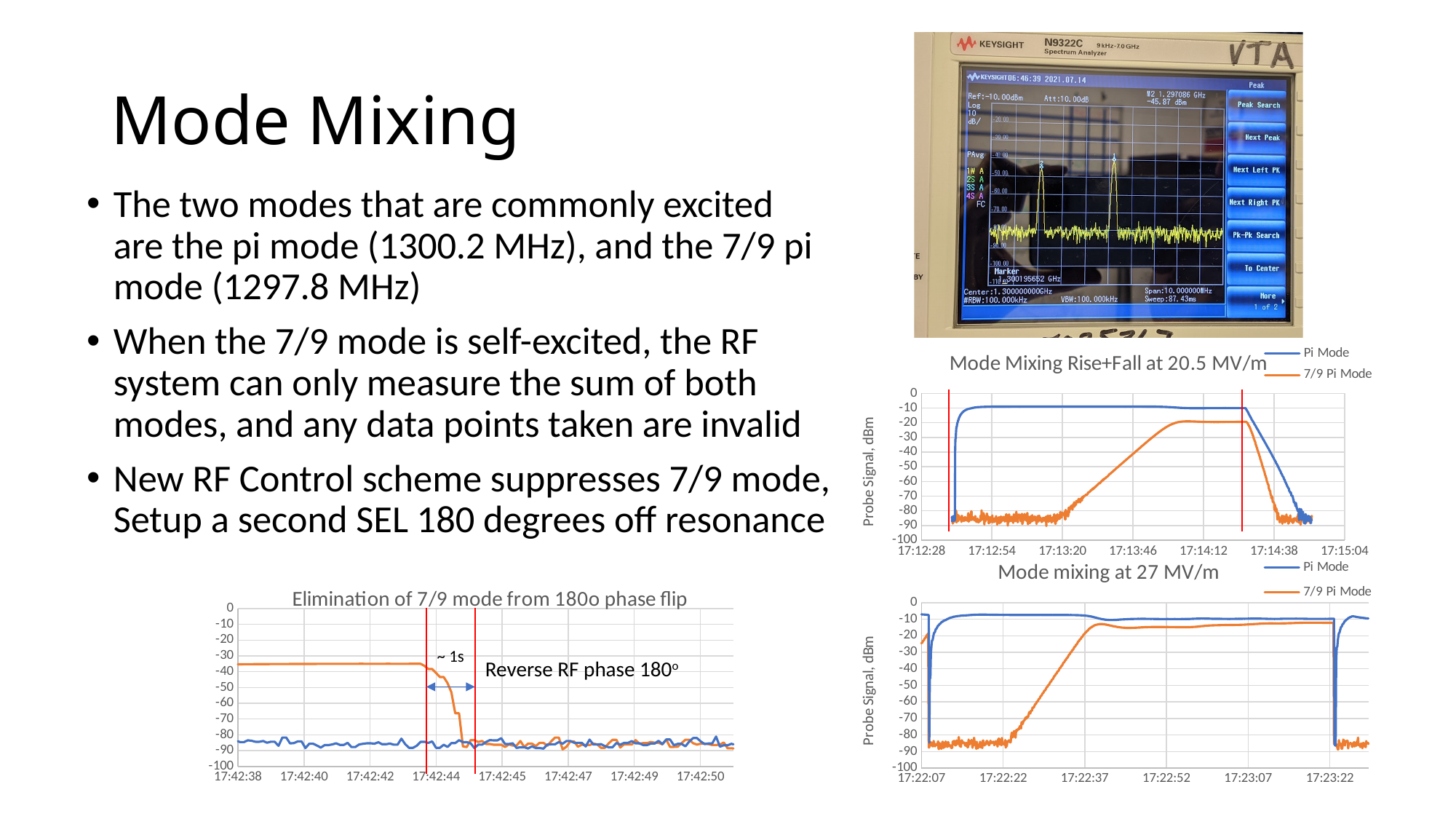
In the "Elimination of 7/9 mode from 180o phase flip" chart, is the orange line's value at 17:42:40 greater or less than -50? greater In the "Mode Mixing Rise+Fall at 20.5 MV/m" chart, which series has the higher value at 17:14:12, Pi Mode or 7/9 Pi Mode? Pi Mode In the "Mode mixing at 27 MV/m" chart, which series has the higher value at 17:22:22, Pi Mode or 7/9 Pi Mode? Pi Mode In the "Elimination of 7/9 mode from 180o phase flip" chart, does the orange line rise or fall between 17:42:44 and 17:42:45? Fall In the "Mode mixing at 27 MV/m" chart, is the 7/9 Pi Mode value at 17:22:52 greater or less than -30? greater What are the two series named in the legend of the "Mode Mixing Rise+Fall at 20.5 MV/m" chart? Pi Mode and 7/9 Pi Mode What kind of chart is the "Mode Mixing Rise+Fall at 20.5 MV/m" chart? Line chart In the "Mode Mixing Rise+Fall at 20.5 MV/m" chart, is the 7/9 Pi Mode value at 17:12:54 greater or less than -70? less What is the y-axis label on the "Mode mixing at 27 MV/m" chart? Probe Signal, dBm How many series does the legend of the "Mode mixing at 27 MV/m" chart list? 2 In the "Mode Mixing Rise+Fall at 20.5 MV/m" chart, does the 7/9 Pi Mode series rise or fall between 17:13:20 and 17:14:12? Rise